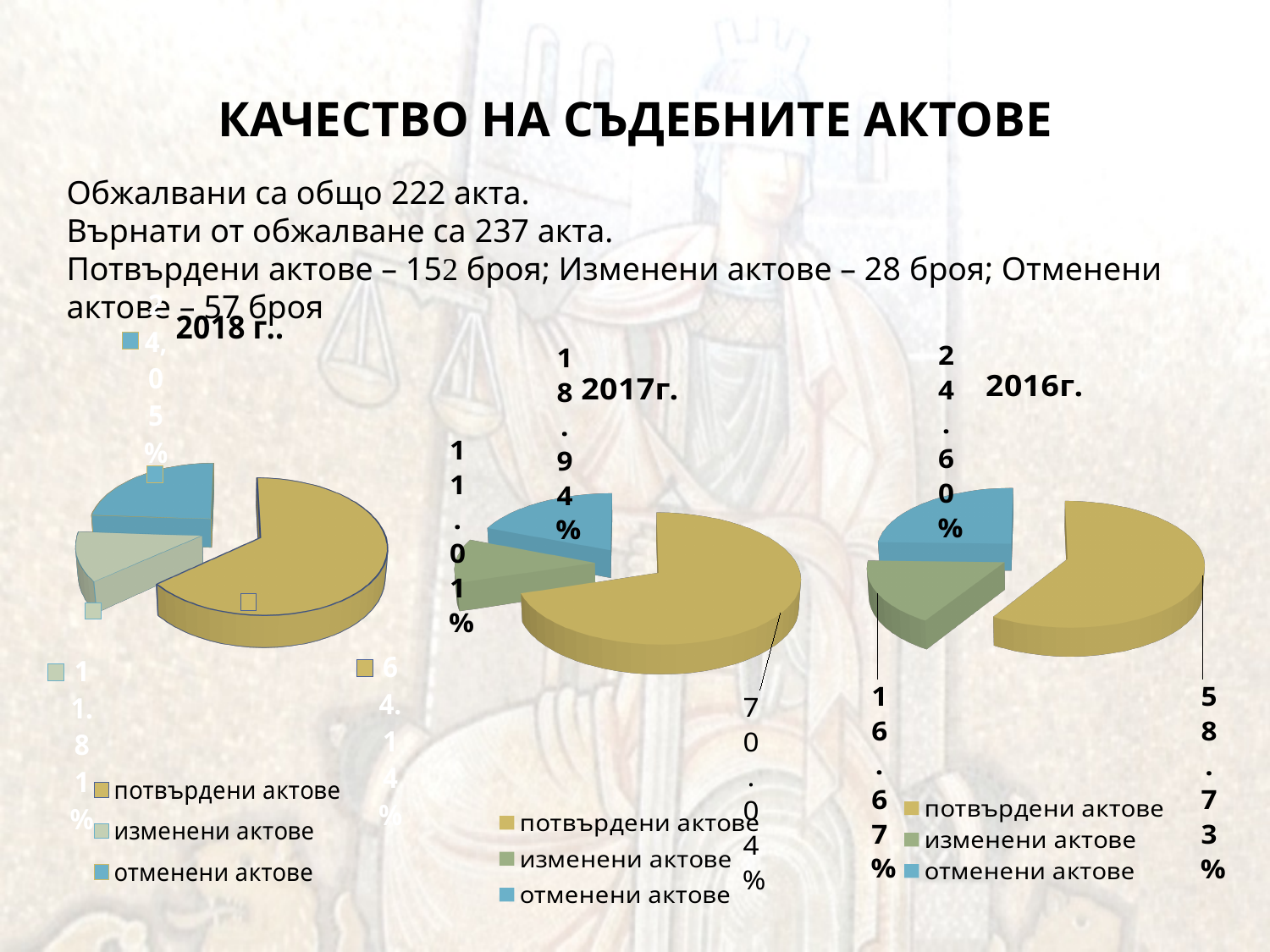
In the 2017г. pie chart, which category has the largest slice? потвърдени актове In the 2016г. pie chart, which category has the smallest slice? изменени актове In the 2017г. pie chart, what share is shown for потвърдени актове? 70.04% In the 2016г. pie chart, what share is shown for отменени актове? 24.60% In the 2017г. pie chart, what share is shown for отменени актове? 18.94% In the 2016г. pie chart, what share is shown for потвърдени актове? 58.73% What kind of charts are shown on the slide? Pie charts How many pie charts are on the slide? 3 How many categories does the legend of the 2016г. pie chart list? 3 In the 2018г. pie chart, what share is shown for потвърдени актове? 64.14% In the 2017г. pie chart, what share is shown for изменени актове? 11.01% In the 2016г. pie chart, what share is shown for изменени актове? 16.67%